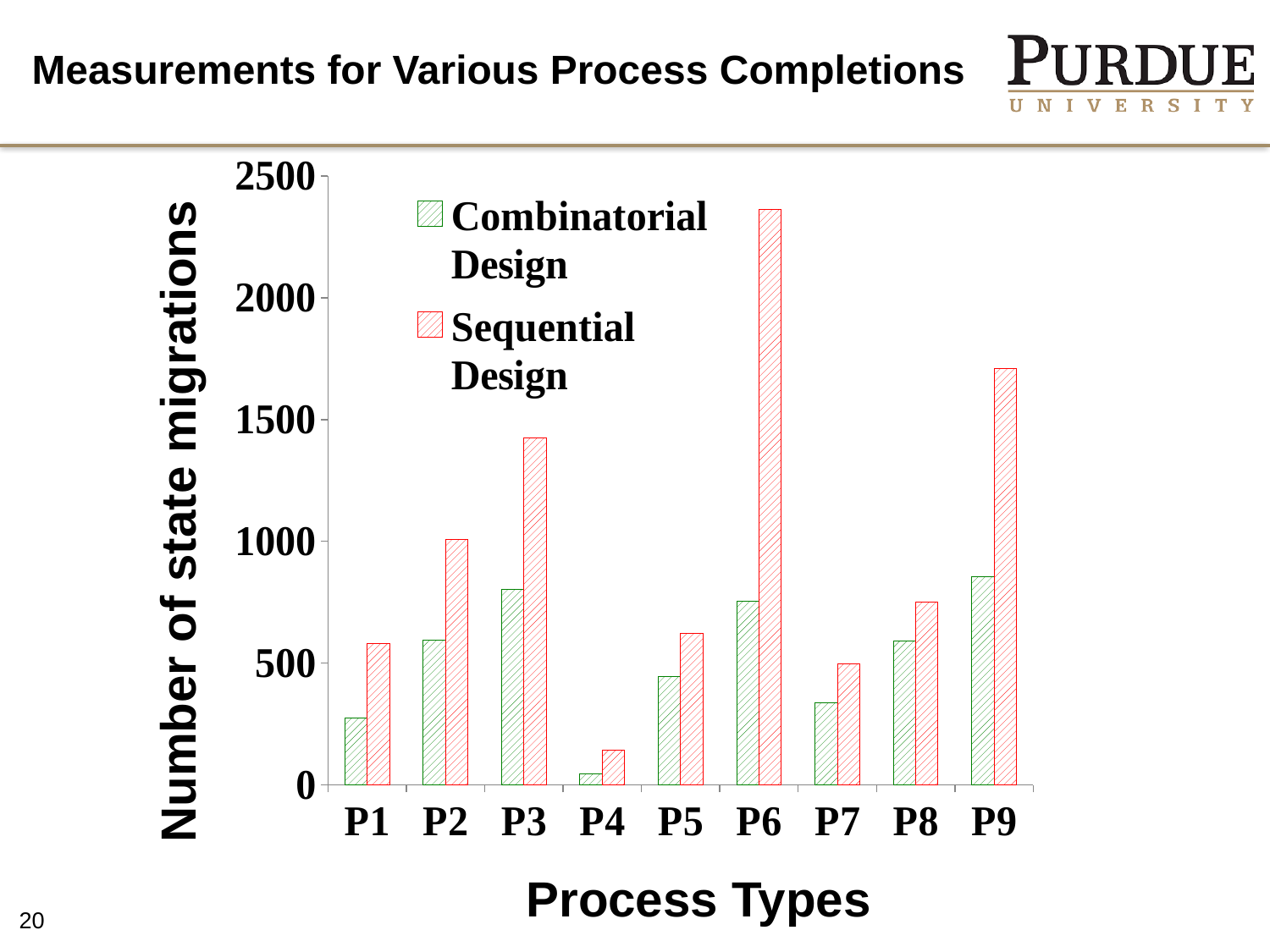
How many process types are shown on the x axis? 9 What is the title of the y axis? Number of state migrations Which is larger for P1: the Combinatorial Design value or the Sequential Design value? Sequential Design Is the Sequential Design value for P6 greater or less than 2000? greater How many series does the legend list? 2 What kind of chart is shown on the slide? bar chart Which process type has the highest Sequential Design value? P6 Which has the larger Combinatorial Design value, P5 or P7? P5 Which process type has the lowest Sequential Design value? P4 Is the Sequential Design value for P9 greater or less than 1500? greater Which process type has the lowest Combinatorial Design value? P4 Is the Combinatorial Design value for P1 greater or less than 500? less